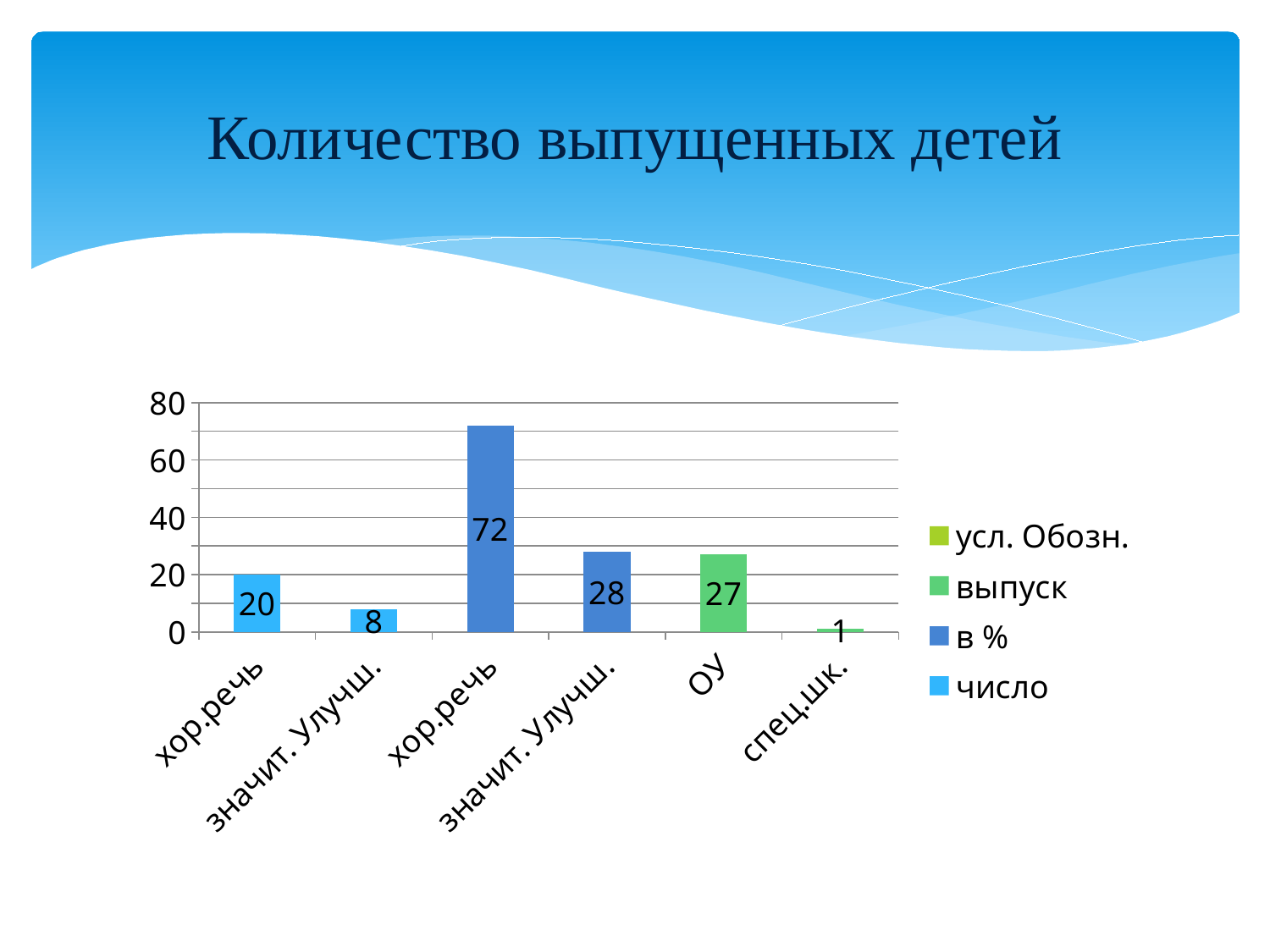
How many series does the legend list? 4 What is the difference between the "в %" values for "хор.речь" and "значит. улучш."? 44 What is the value of the "число" bar for "значит. улучш."? 8 Which is larger: the "выпуск" value for "ОУ" or the "число" value for "хор.речь"? ОУ What is the value of the "в %" bar for "хор.речь"? 72 What is the value of the "выпуск" bar for "ОУ"? 27 What type of chart is shown on the slide? Bar chart Which bar has the lowest value on the chart? спец.шк., 1 What is the value of the "число" bar for "хор.речь"? 20 What is the value of the "выпуск" bar for "спец.шк."? 1 Which bar has the highest value on the chart? хор.речь (в %), 72 How many bars are plotted on the chart? 6